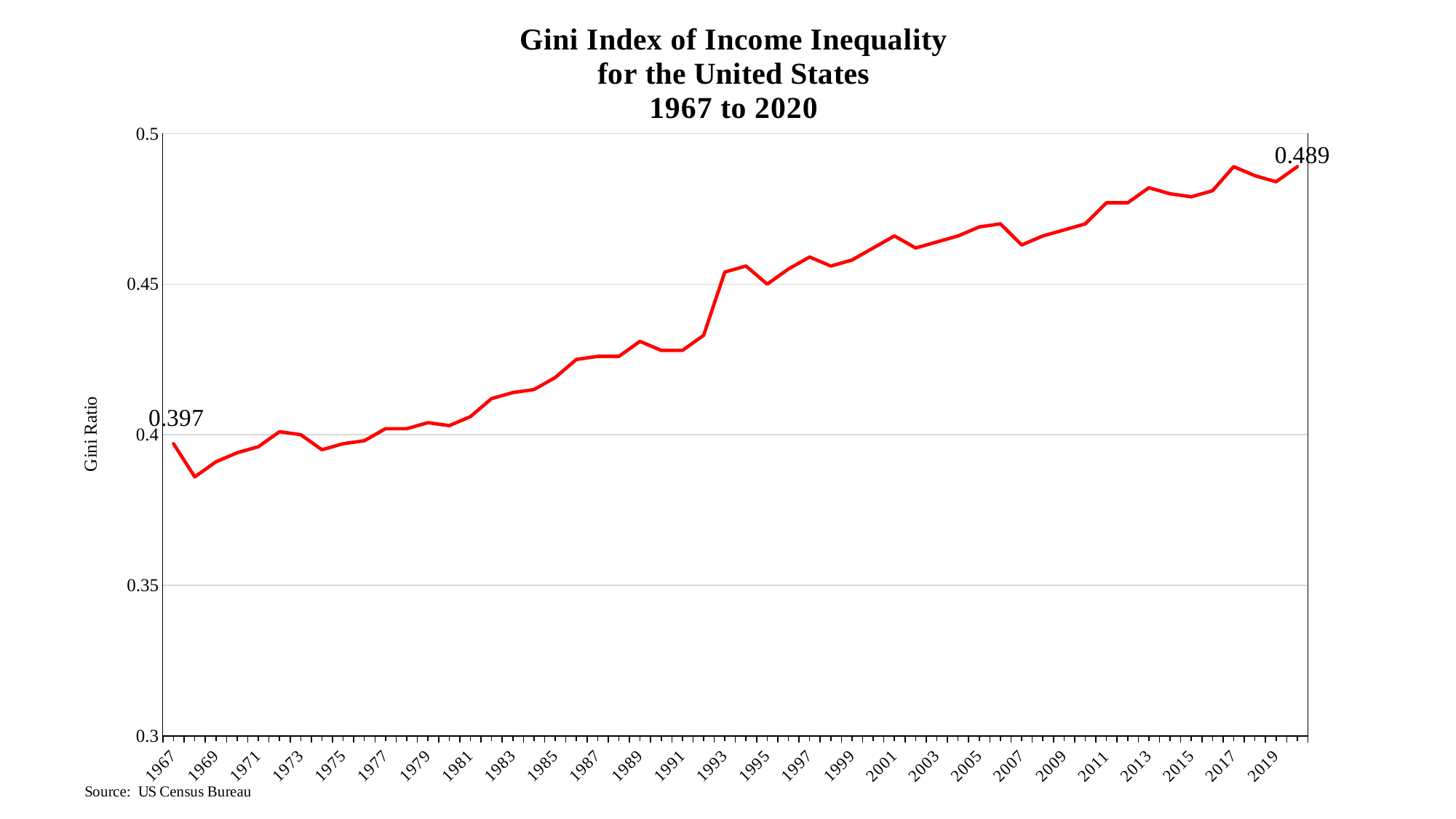
Is the Gini ratio for 1969 greater or less than 0.4? less Which year has the higher Gini ratio, 1967 or 2020? 2020 By how much did the Gini ratio increase from 1967 (0.397) to 2020 (0.489)? 0.092 What type of chart is shown on the slide? line chart What is the Gini ratio value labelled at the end of the line, for 2020? 0.489 Does the Gini ratio generally rise or fall from 1967 to 2020? rise Is the Gini ratio for 2011 greater or less than 0.45? greater Is the Gini ratio for 1989 greater or less than 0.45? less Which year shows the lowest Gini ratio on the chart? 1968 What is the Gini ratio value labelled for 1967? 0.397 What is the label on the vertical axis of the chart? Gini Ratio How many lines (series) are plotted on the chart? 1